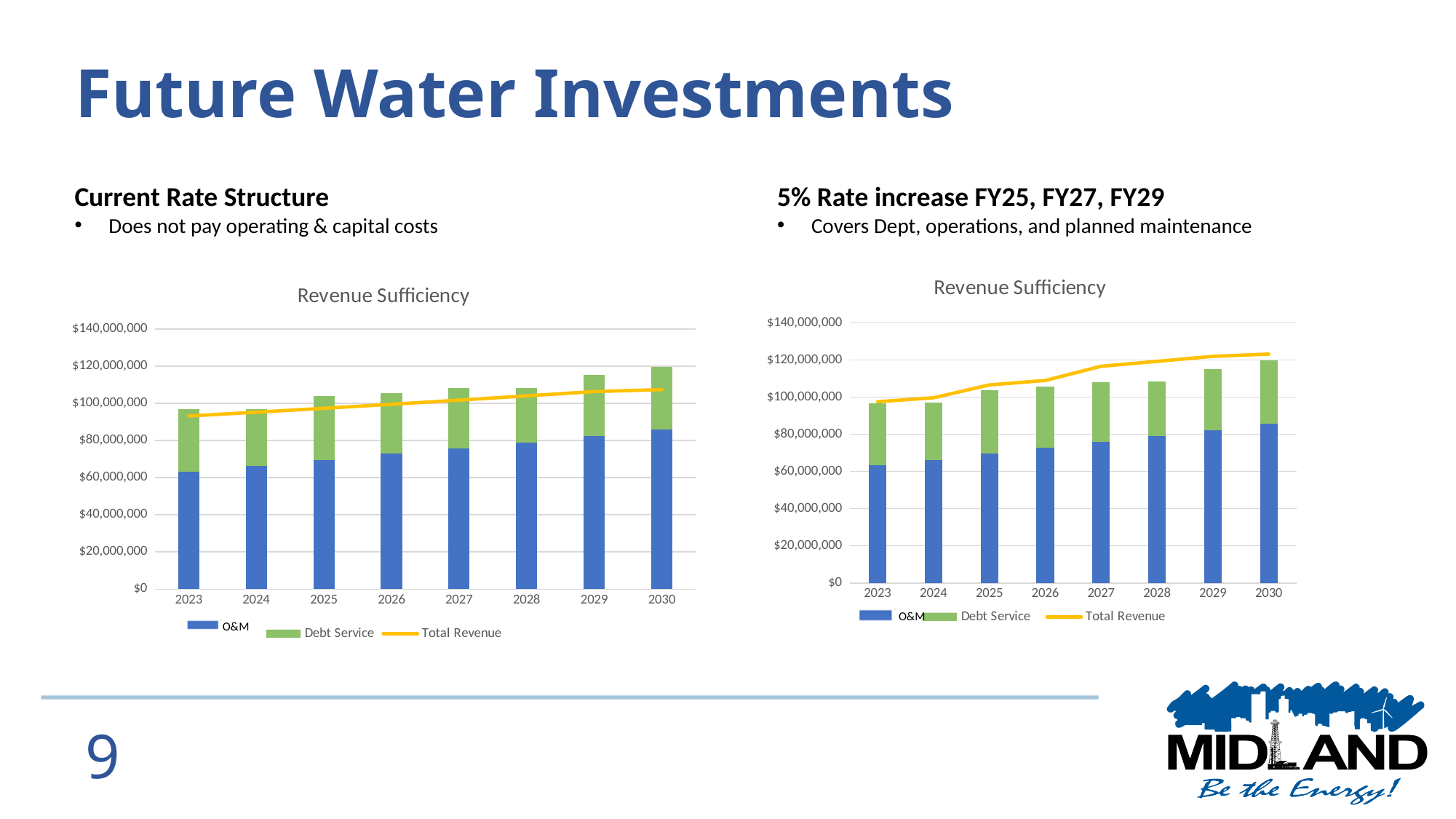
On the left chart, which is larger, the O&M value for 2030 or the O&M value for 2023? 2030 On the right chart, how many series does the legend list? 3 What is the title of the right chart? Revenue Sufficiency On the right chart, in which year is the O&M value highest? 2030 On the left chart, is the O&M value for 2023 greater or less than $80,000,000? less On the right chart, does the Total Revenue line rise or fall from 2023 to 2030? rise What kind of chart is the left chart? combination bar and line chart On the left chart, is the O&M value for 2030 greater or less than $80,000,000? greater On the left chart, is the Total Revenue value for 2030 greater or less than $100,000,000? greater On the left chart, how many years are shown on the x axis? 8 On the left chart, in which year is the O&M value lowest? 2023